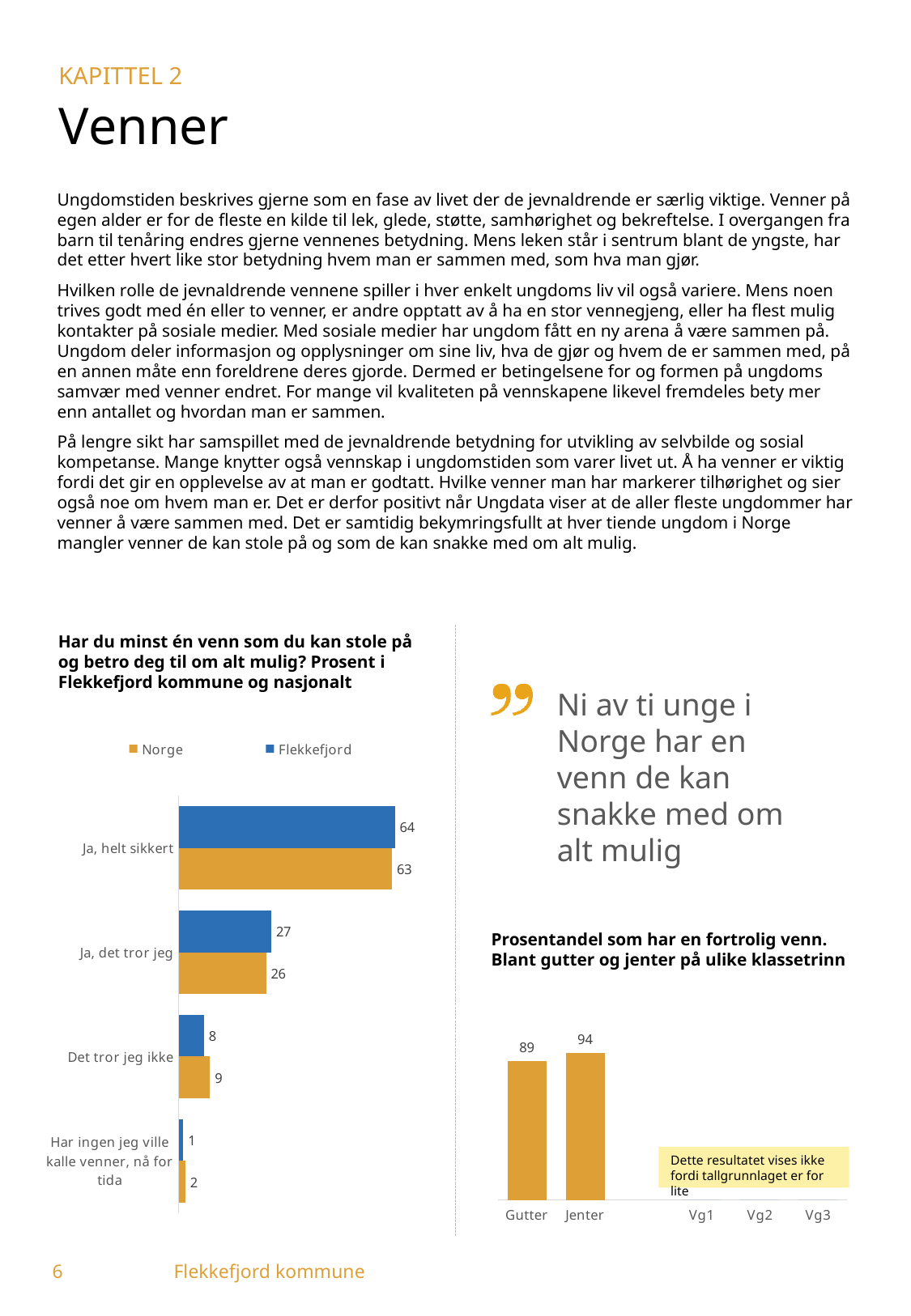
In the chart 'Har du minst én venn som du kan stole på og betro deg til om alt mulig?', what is the value for Norge for 'Det tror jeg ikke'? 9 In the chart 'Har du minst én venn som du kan stole på og betro deg til om alt mulig?', what is the difference between the Flekkefjord and Norge values for 'Ja, helt sikkert'? 1 In the chart 'Har du minst én venn som du kan stole på og betro deg til om alt mulig?', what is the value for Norge for 'Ja, det tror jeg'? 26 In the chart 'Har du minst én venn som du kan stole på og betro deg til om alt mulig?', what is the value for Flekkefjord for 'Ja, helt sikkert'? 64 In the chart 'Prosentandel som har en fortrolig venn', what is the value for Jenter? 94 In the chart 'Har du minst én venn som du kan stole på og betro deg til om alt mulig?', which category has the lowest value for Norge? Har ingen jeg ville kalle venner, nå for tida In the chart 'Har du minst én venn som du kan stole på og betro deg til om alt mulig?', which category has the highest value for Flekkefjord? Ja, helt sikkert In the chart 'Har du minst én venn som du kan stole på og betro deg til om alt mulig?', how many categories are shown? 4 In the chart 'Har du minst én venn som du kan stole på og betro deg til om alt mulig?', how many series does the legend list? 2 In the chart 'Prosentandel som har en fortrolig venn', what is the difference between Jenter and Gutter? 5 In the chart 'Prosentandel som har en fortrolig venn', which is larger, Gutter or Jenter? Jenter What kind of chart is 'Har du minst én venn som du kan stole på og betro deg til om alt mulig?'? Bar chart